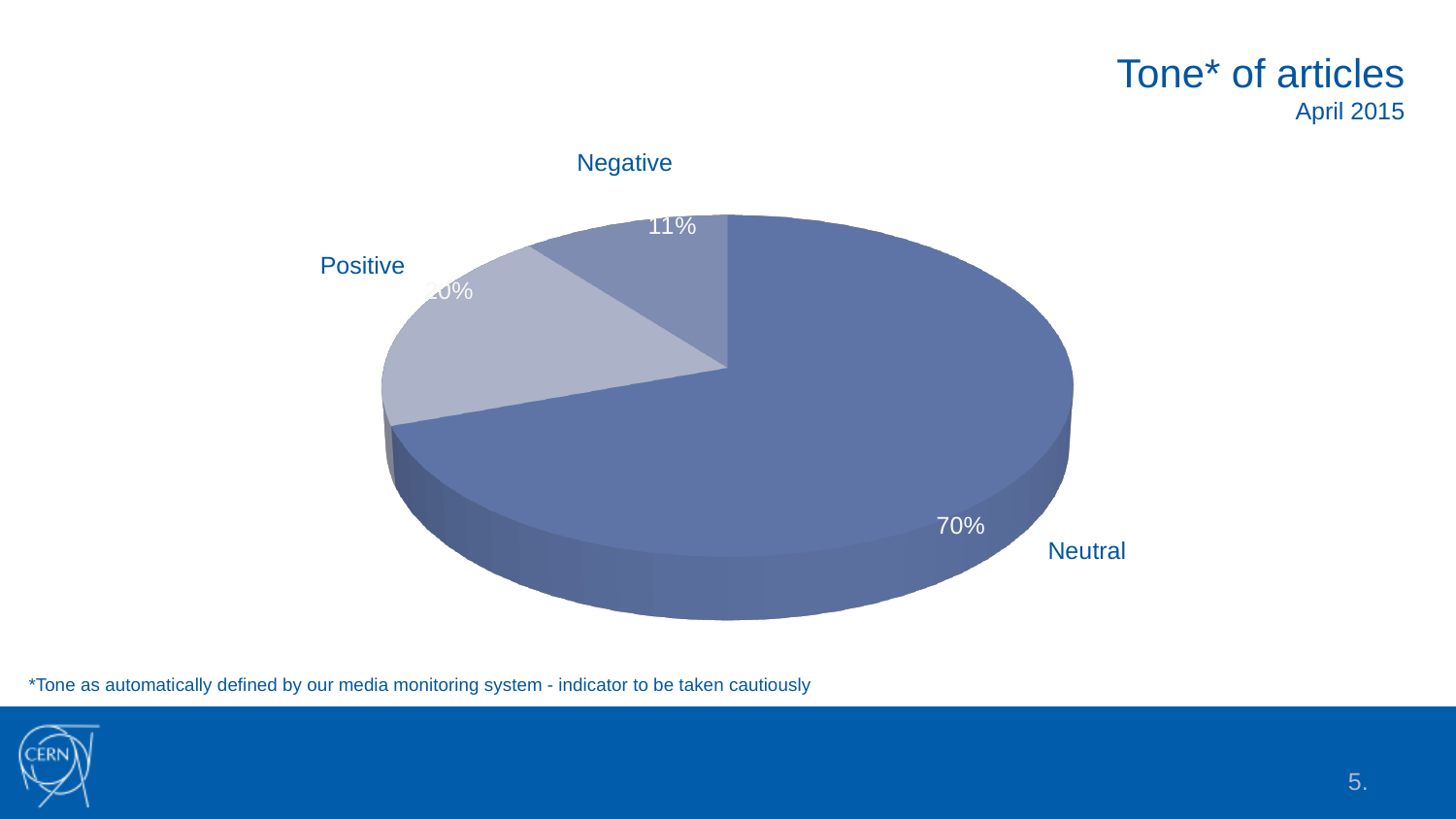
What share of articles has a Neutral tone? 70% Which tone category has the largest slice of the pie? Neutral What percentage of the pie does the Neutral slice represent? 70% Which tone category has the smallest slice of the pie? Negative Which is larger, the Neutral slice or the Negative slice? Neutral What share of articles has a Negative tone? 11% Which is larger, the Positive slice or the Negative slice? Positive How many tone categories are shown in the pie chart? 3 What is the title of the chart? Tone* of articles Which month and year does the chart cover? April 2015 By how many percentage points does the Neutral share exceed the Negative share? 59% What kind of chart is shown on the slide? pie chart